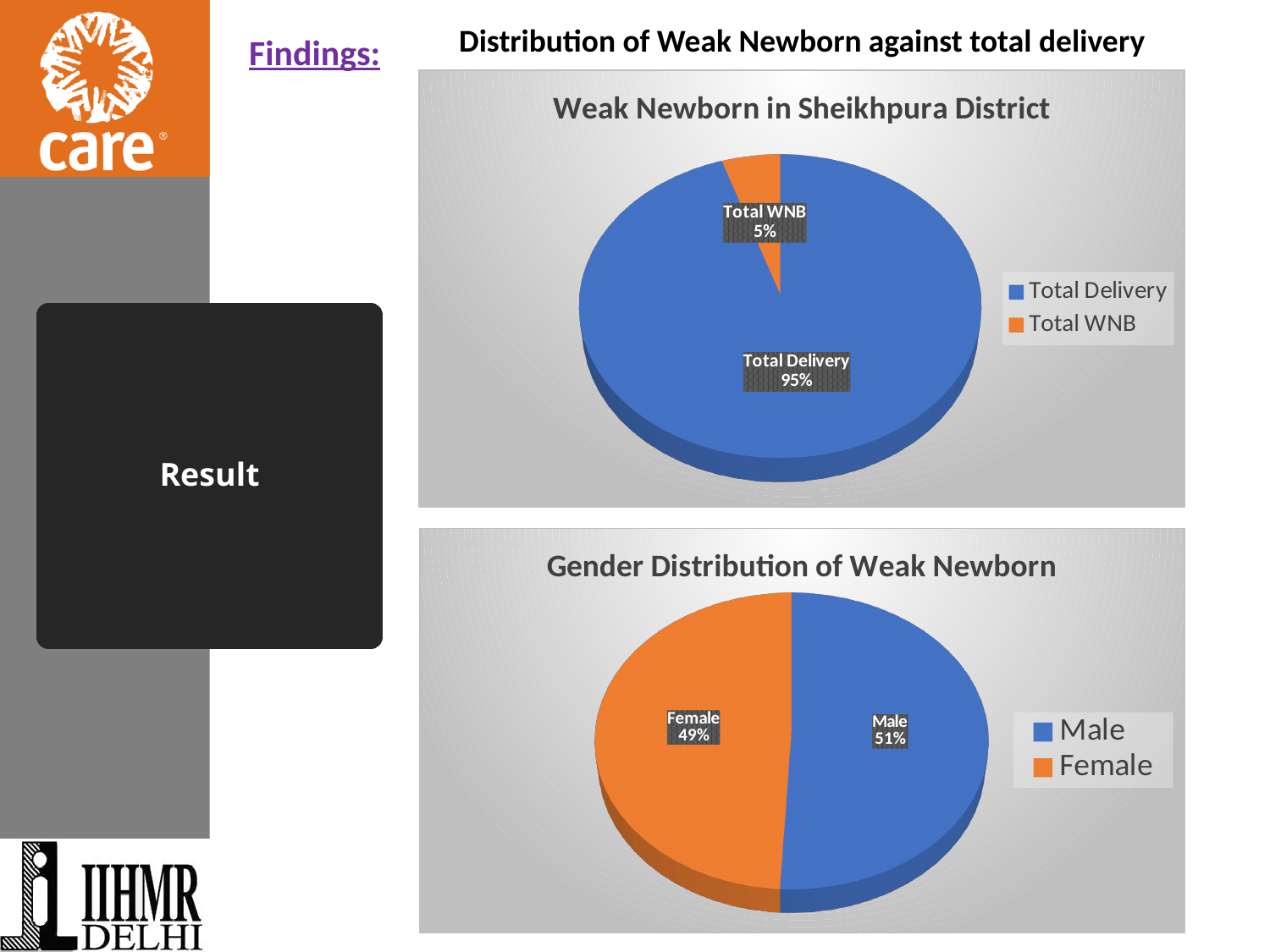
In the 'Gender Distribution of Weak Newborn' chart, what is the difference between the Male and Female shares? 2% In the 'Weak Newborn in Sheikhpura District' chart, what is the difference between the Total Delivery and Total WNB shares? 90% In the 'Weak Newborn in Sheikhpura District' chart, what share of the pie is Total WNB? 5% In the 'Gender Distribution of Weak Newborn' chart, what share of the pie is Female? 49% In the 'Gender Distribution of Weak Newborn' chart, what share of the pie is Male? 51% How many slices does the 'Weak Newborn in Sheikhpura District' pie chart have? 2 In the 'Weak Newborn in Sheikhpura District' chart, which slice is the largest? Total Delivery What kind of chart is 'Weak Newborn in Sheikhpura District'? Pie chart In the 'Gender Distribution of Weak Newborn' chart, which slice is smaller, Male or Female? Female In the 'Gender Distribution of Weak Newborn' chart, what colour is the Female slice? Orange How many entries does the legend of the 'Gender Distribution of Weak Newborn' chart list? 2